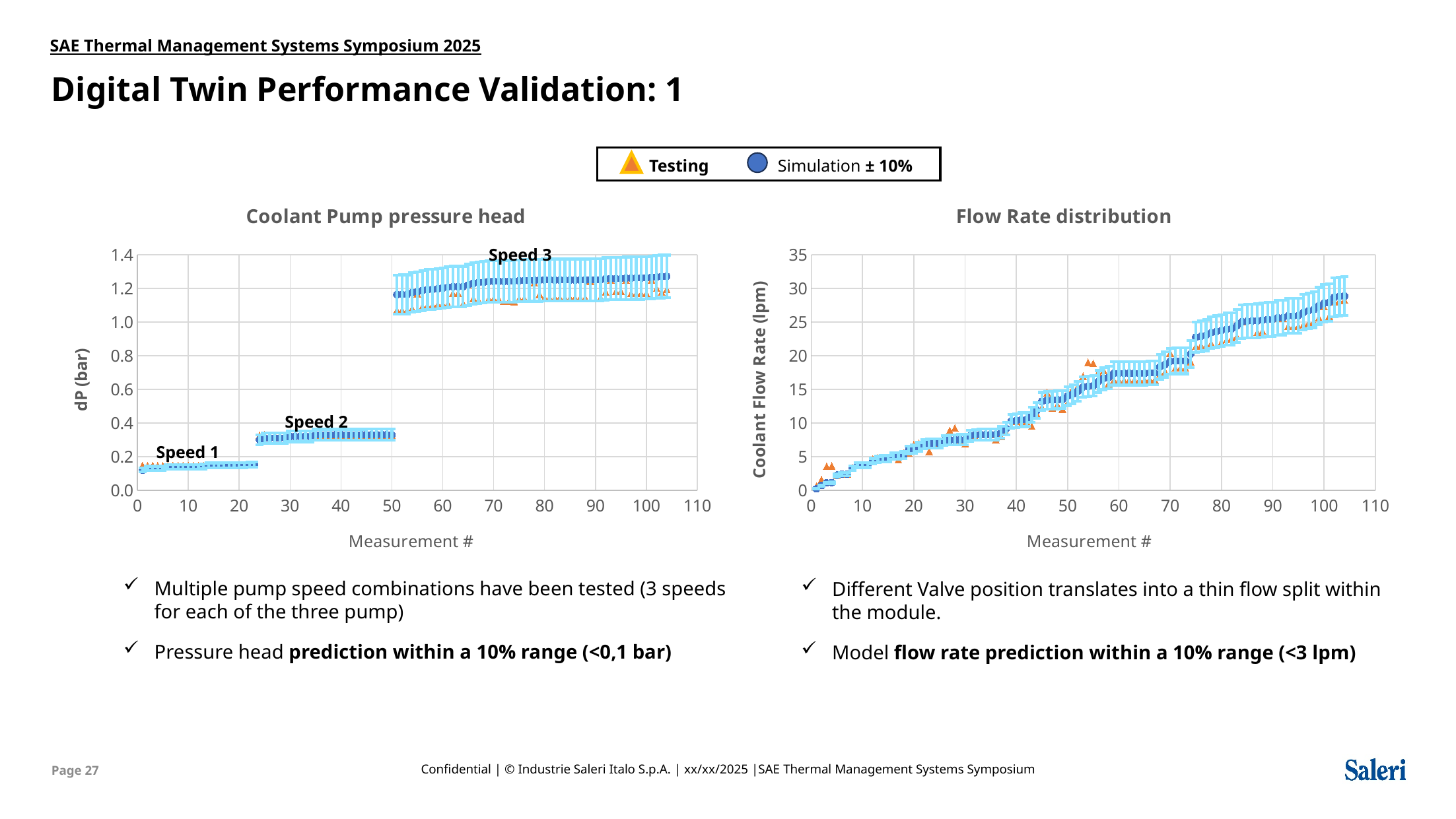
What is the y-axis title of the Flow Rate distribution chart? Coolant Flow Rate (lpm) In the Coolant Pump pressure head chart, are the dP values for Speed 3 greater or less than 1.0 bar? greater In the Flow Rate distribution chart, do the coolant flow rate values rise or fall as the measurement number increases? rise In the Coolant Pump pressure head chart, which speed group has the lowest dP values? Speed 1 In the Flow Rate distribution chart, is the coolant flow rate at measurement 100 greater or less than 25 lpm? greater In the Coolant Pump pressure head chart, how many speed groups are labelled? 3 In the Coolant Pump pressure head chart, are the dP values for Speed 2 greater or less than 0.4 bar? less What kind of chart is the Coolant Pump pressure head chart? Scatter chart How many series does the legend list for the charts? 2 In the Coolant Pump pressure head chart, which has larger dP values, Speed 2 or Speed 3? Speed 3 In the Coolant Pump pressure head chart, which speed group has the highest dP values? Speed 3